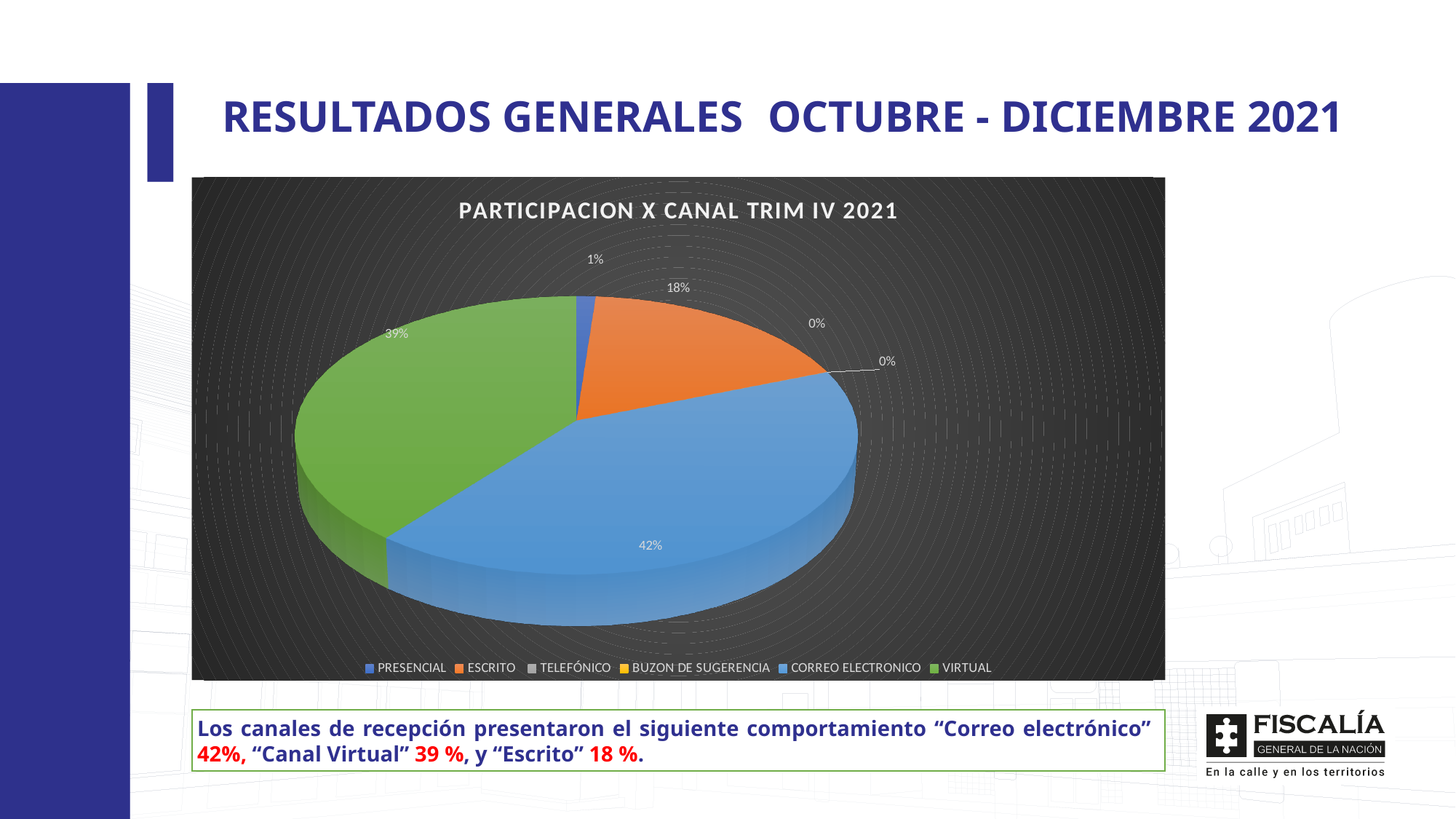
How many categories does the legend of the pie chart list? 6 Which category has the largest share of the pie? CORREO ELECTRONICO What is the difference in percentage points between the VIRTUAL share and the ESCRITO share? 21 percentage points What share of the pie does VIRTUAL represent? 39% What is the difference in percentage points between the CORREO ELECTRONICO share and the VIRTUAL share? 3 percentage points Which is larger, the share for ESCRITO or the share for VIRTUAL? VIRTUAL What kind of chart is shown on the slide? Pie chart What share of the pie does CORREO ELECTRONICO represent? 42% What share of the pie does PRESENCIAL represent? 1% What is the title of the chart? PARTICIPACION X CANAL TRIM IV 2021 Which colour represents VIRTUAL in the pie chart? Green